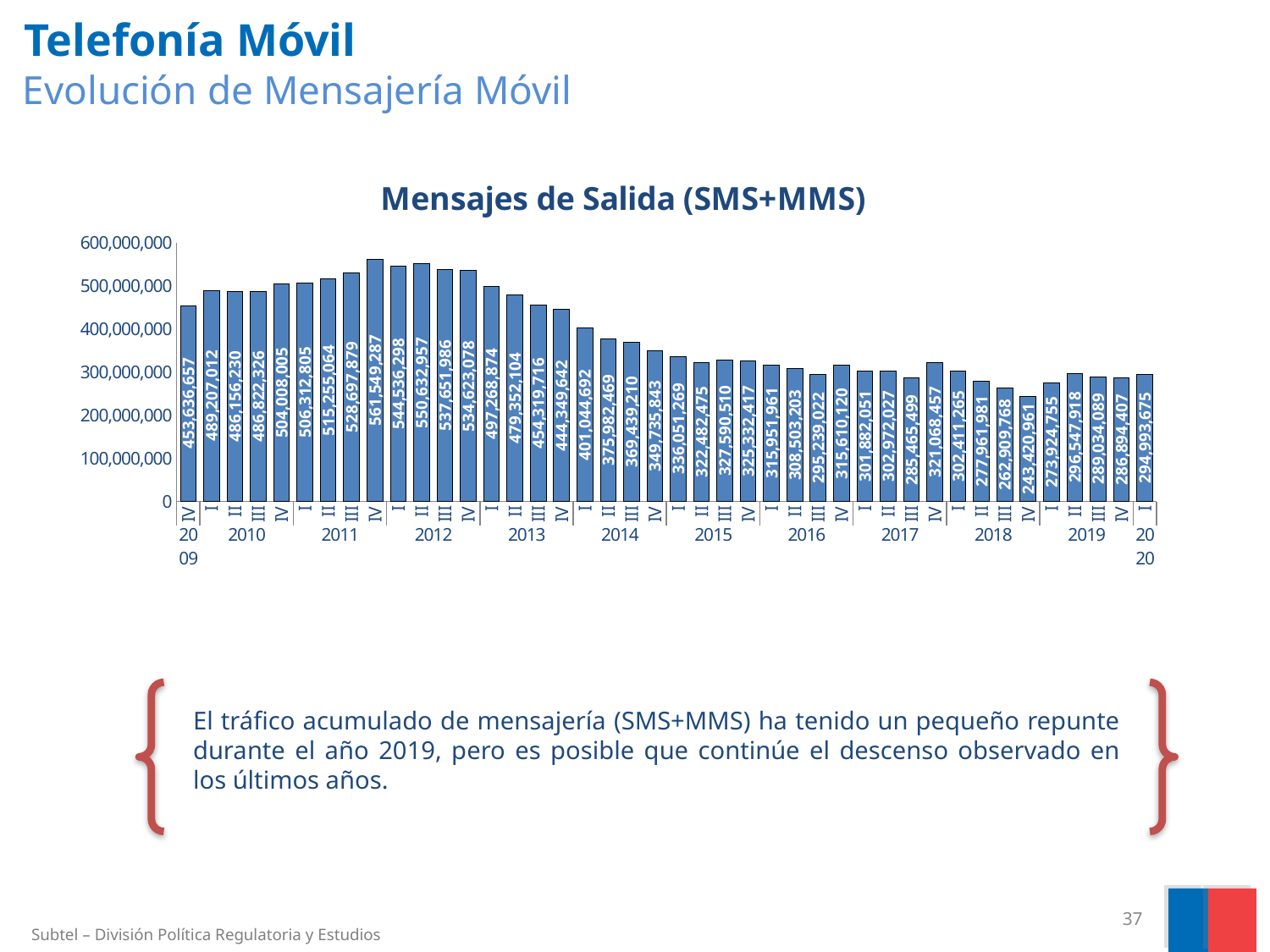
By how much did the value increase from quarter IV of 2018 to quarter I of 2019 in the Mensajes de Salida (SMS+MMS) chart? 30,503,794 Which quarter has the highest value in the Mensajes de Salida (SMS+MMS) chart? IV 2011 How many quarterly bars are plotted in the Mensajes de Salida (SMS+MMS) chart? 42 Do the values in the Mensajes de Salida (SMS+MMS) chart rise or fall from quarter I of 2013 to quarter IV of 2014? fall Which is larger in the Mensajes de Salida (SMS+MMS) chart: the value for quarter I of 2014 or the value for quarter I of 2015? I 2014 What is the value for quarter IV of 2011 in the Mensajes de Salida (SMS+MMS) chart? 561,549,287 What is the difference between the highest value (IV 2011) and the lowest value (IV 2018) in the Mensajes de Salida (SMS+MMS) chart? 318,128,326 What is the value for quarter I of 2020 in the Mensajes de Salida (SMS+MMS) chart? 294,993,675 Which quarter has the lowest value in the Mensajes de Salida (SMS+MMS) chart? IV 2018 What is the value for quarter IV of 2018 in the Mensajes de Salida (SMS+MMS) chart? 243,420,961 What kind of chart is used to show Mensajes de Salida (SMS+MMS)? bar chart Is the value for quarter II of 2014 in the Mensajes de Salida (SMS+MMS) chart greater or less than 400,000,000? less